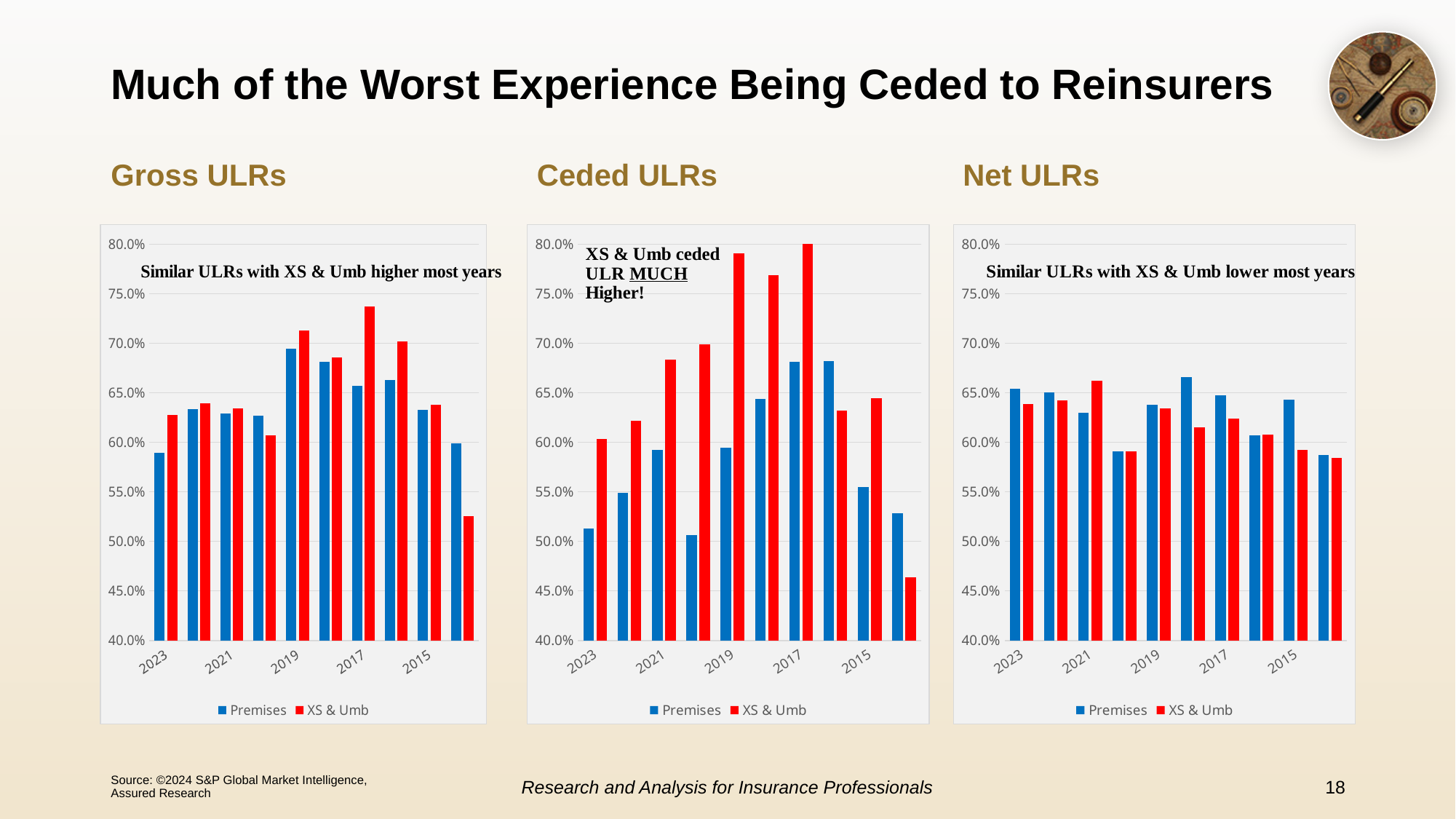
In the Net ULRs chart, which series has the larger value for 2019, Premises or XS & Umb? Premises In the Ceded ULRs chart, which series has the larger value for 2019, Premises or XS & Umb? XS & Umb How many series does the legend of the Ceded ULRs chart list? 2 In the Ceded ULRs chart, which year has the lowest XS & Umb bar? 2014 In the Net ULRs chart, is the Premises value for 2019 greater or less than 65.0%? less In the Gross ULRs chart, which year has the highest XS & Umb bar? 2017 In the Gross ULRs chart, do the XS & Umb values rise or fall from 2017 to 2014? fall In the Net ULRs chart, which year has the highest Premises bar? 2018 What kind of chart is the Gross ULRs chart? bar chart In the Gross ULRs chart, is the XS & Umb value for 2014 greater or less than 55.0%? less In the Ceded ULRs chart, is the XS & Umb value for 2019 greater or less than 75.0%? greater How many years (category groups) are plotted in the Net ULRs chart? 10